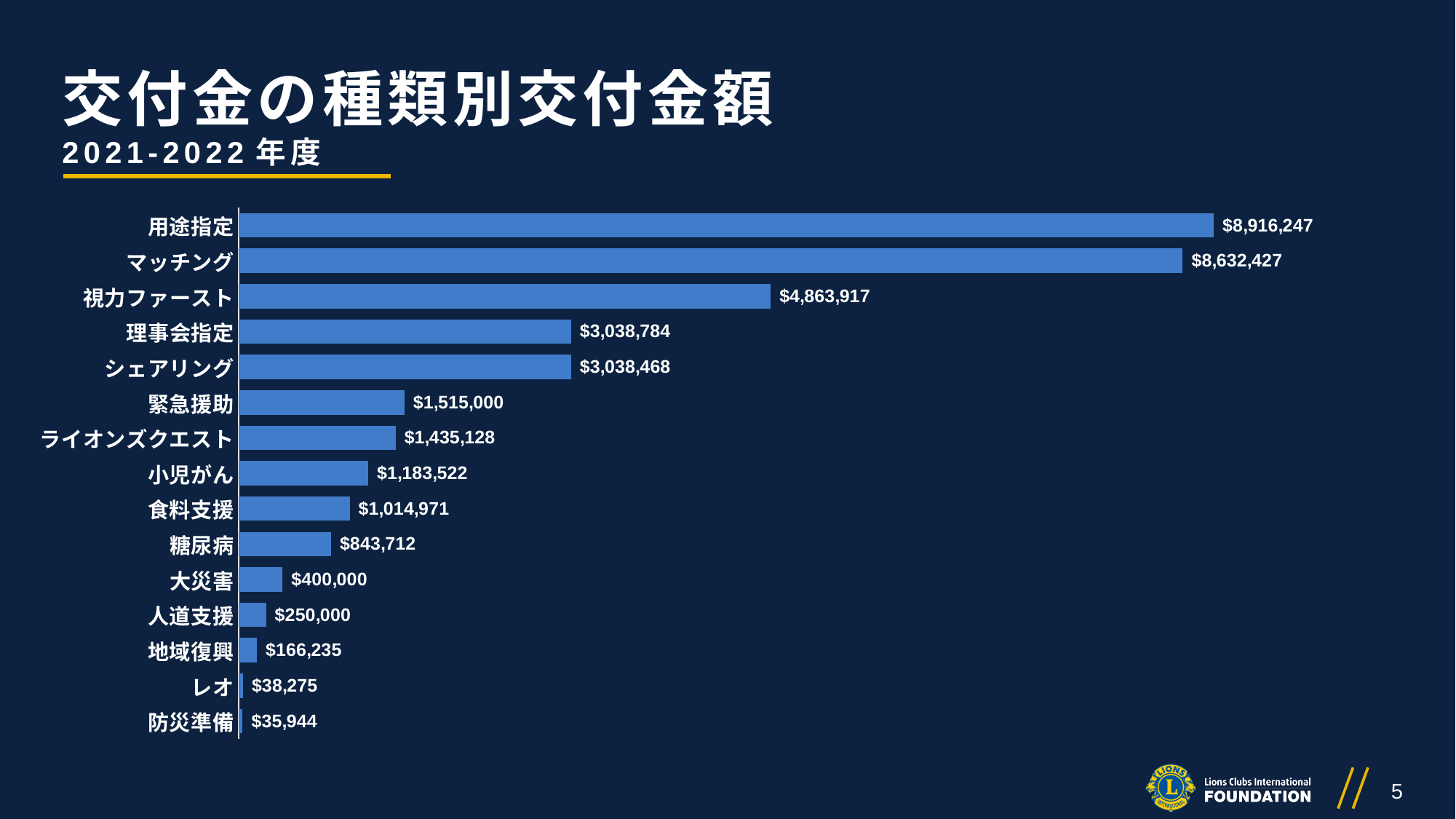
What is the value for 視力ファースト? $4,863,917 What is the difference between the values for 大災害 and 人道支援? $150,000 Which is larger, the value for 小児がん or the value for 食料支援? 小児がん What kind of chart is shown on the slide? Bar chart What period does the subtitle of the slide indicate? 2021-2022 年度 What is the difference between the values for 用途指定 and マッチング? $283,820 Which category has the highest value? 用途指定 What is the value for 用途指定? $8,916,247 How many categories are shown in the chart? 15 Which category has the lowest value? 防災準備 What is the value for 地域復興? $166,235 What is the value for 糖尿病? $843,712